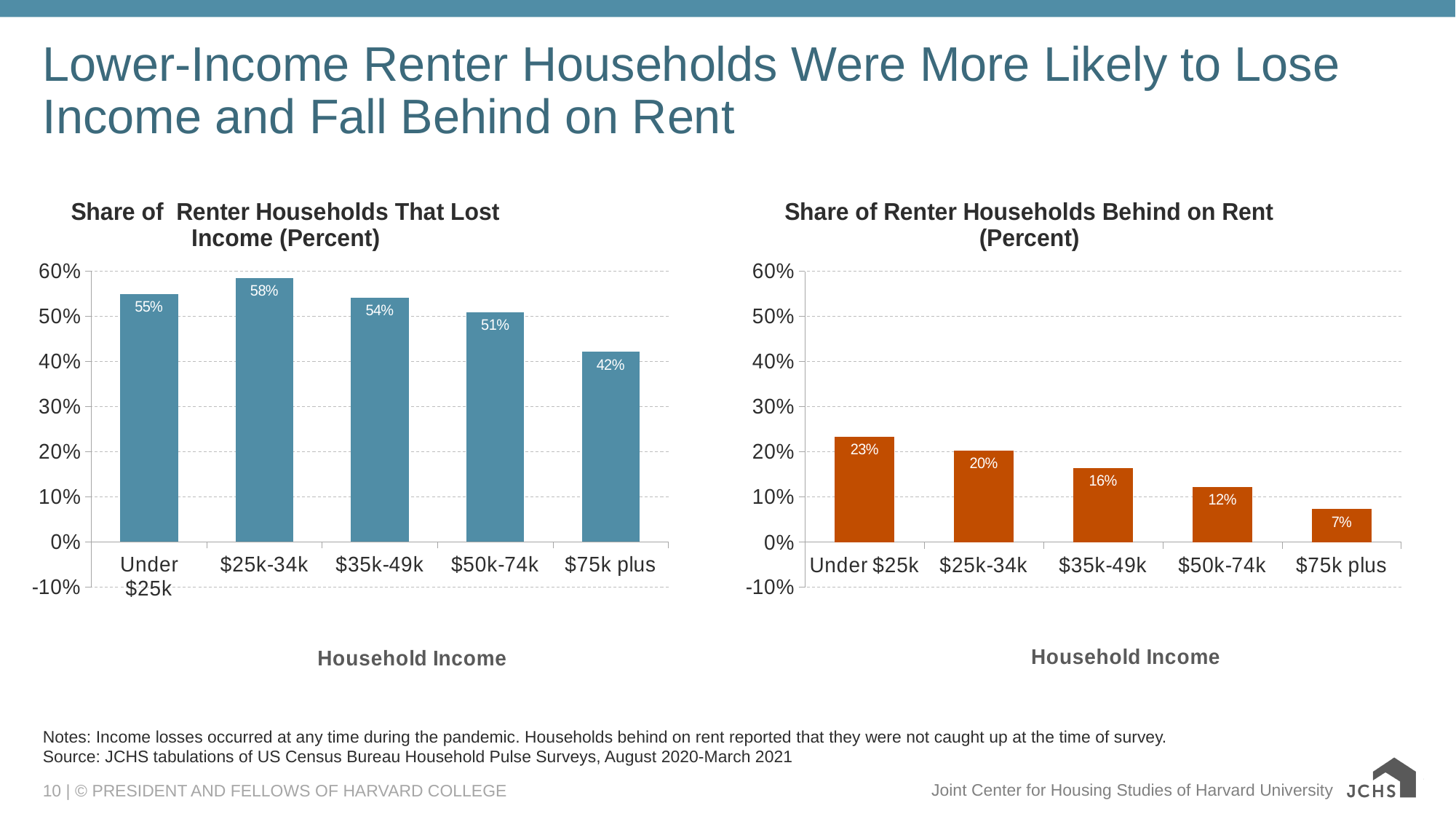
In the 'Share of Renter Households Behind on Rent (Percent)' chart, what is the value for $50k-74k? 12% In the 'Share of Renter Households Behind on Rent (Percent)' chart, which household income category has the lowest value? $75k plus What kind of chart is the 'Share of Renter Households That Lost Income (Percent)' chart? Bar chart In the 'Share of Renter Households That Lost Income (Percent)' chart, which household income category has the highest value? $25k-34k In the 'Share of Renter Households That Lost Income (Percent)' chart, what is the value for $75k plus? 42% In the 'Share of Renter Households Behind on Rent (Percent)' chart, do the values rise or fall as household income increases along the x axis? Fall In the 'Share of Renter Households That Lost Income (Percent)' chart, what is the difference between the values for $25k-34k and $50k-74k? 7% In the 'Share of Renter Households That Lost Income (Percent)' chart, what is the value for $25k-34k? 58% In the 'Share of Renter Households Behind on Rent (Percent)' chart, what is the difference between the values for Under $25k and $75k plus? 16% In the 'Share of Renter Households Behind on Rent (Percent)' chart, what is the value for Under $25k? 23% In the 'Share of Renter Households Behind on Rent (Percent)' chart, which is larger, the value for $25k-34k or the value for $35k-49k? $25k-34k How many household income categories are shown in the 'Share of Renter Households Behind on Rent (Percent)' chart? 5